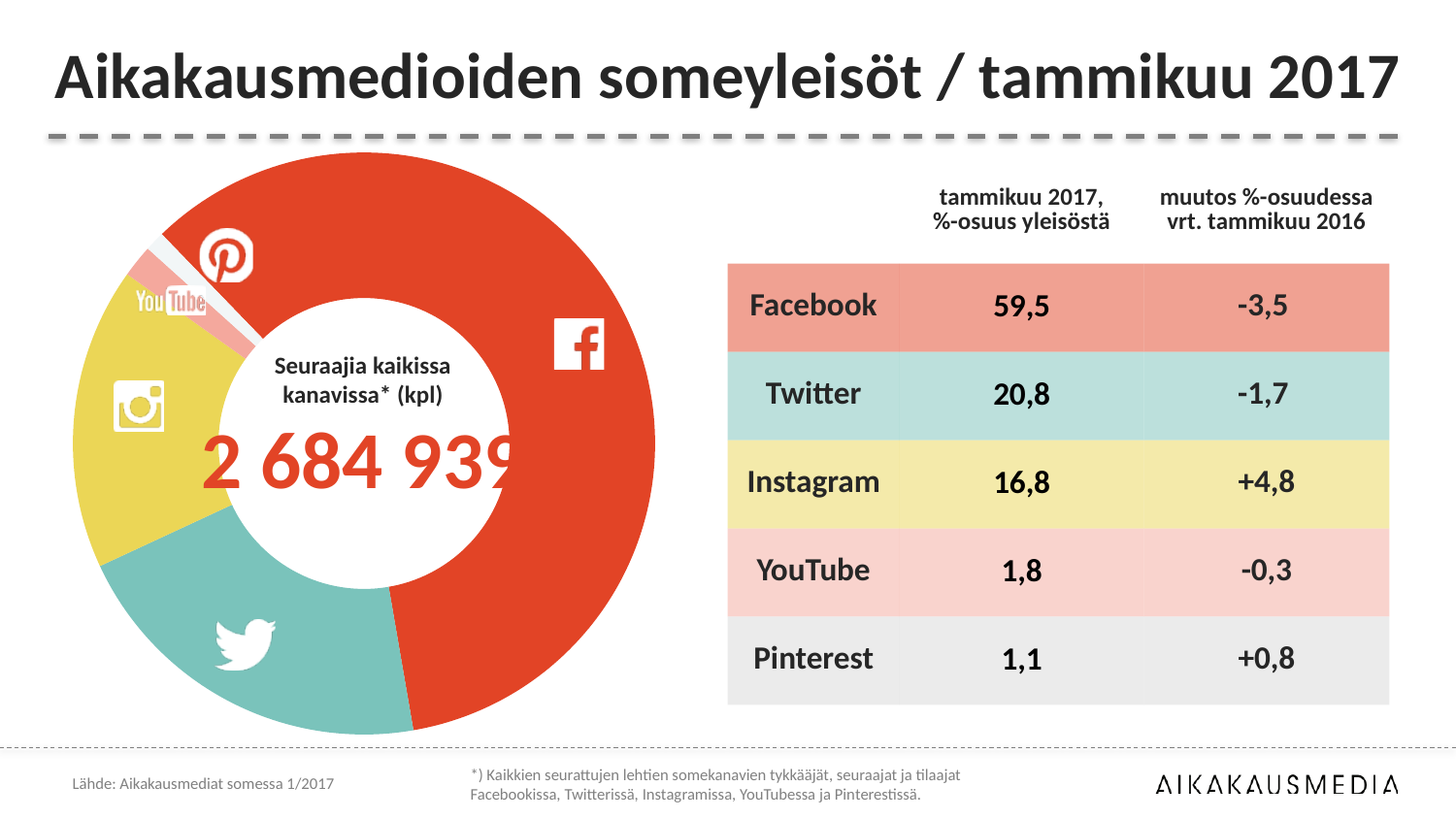
Which channel has the smallest share of the audience in January 2017? Pinterest How many channels (slices) does the donut chart show? 5 What is Instagram's percentage share of the audience in January 2017? 16,8 What is the change in Facebook's percentage share compared with January 2016? -3,5 What is the difference in percentage share between Facebook and Twitter in January 2017? 38,7 What is Facebook's percentage share of the audience in January 2017? 59,5 Which channel has the largest share of the audience in January 2017? Facebook What kind of chart is shown on the left of the slide? Donut (pie) chart What total number of followers across all channels is shown in the centre of the donut chart? 2 684 939 Which has a larger share of the audience, Twitter or Instagram? Twitter Which channel is represented by the teal slice of the donut chart? Twitter What is the change in Instagram's percentage share compared with January 2016? +4,8